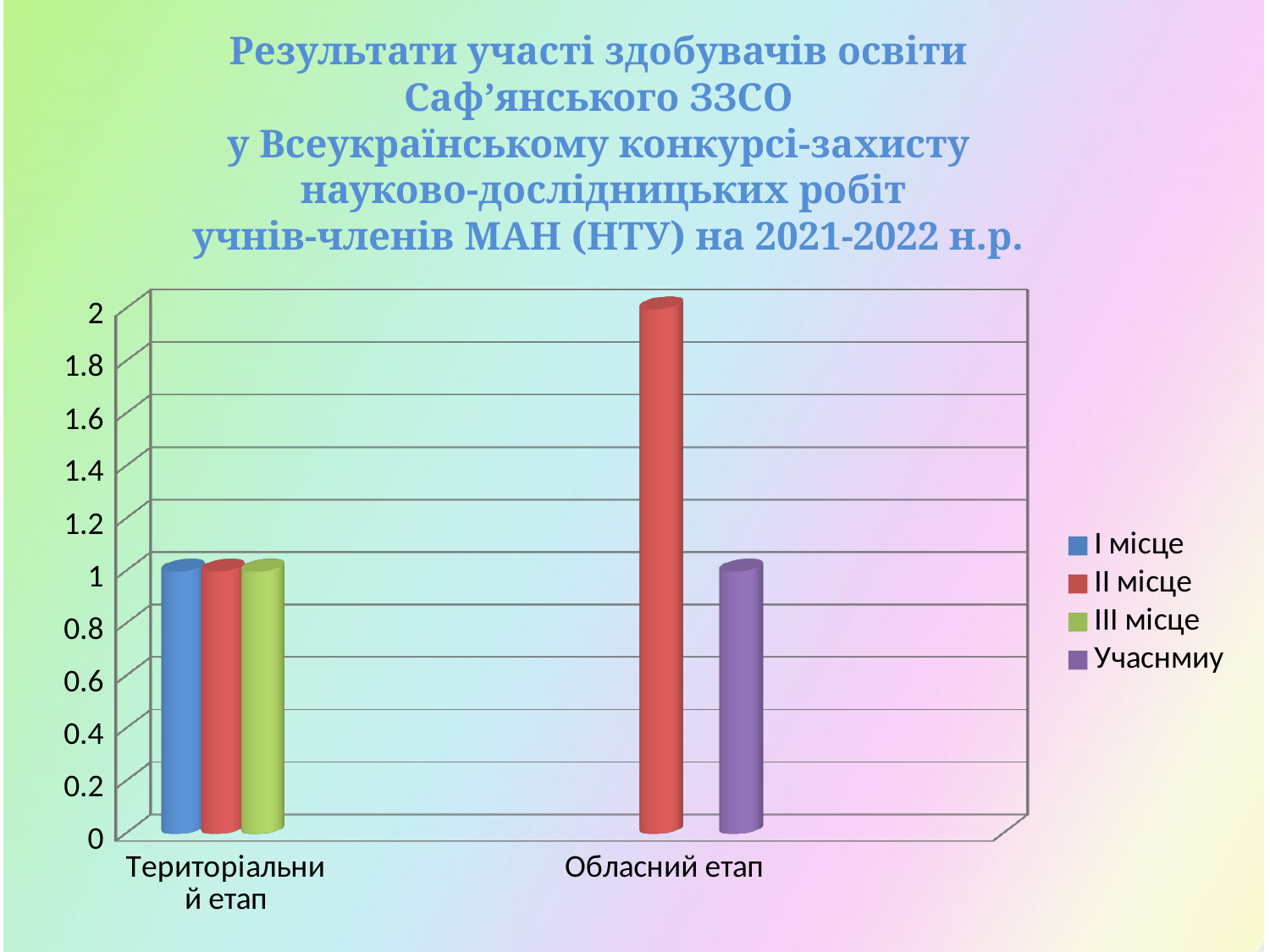
Which legend entry is shown in purple? Учаснмиу Is the value for III місце at Територіальний етап greater or less than 1.5? less Which series has the highest value at Обласний етап? II місце What is the value for Учаснмиу at Обласний етап? 1 Is the value for II місце at Обласний етап greater or less than 1.5? greater How many series does the legend list? 4 What is the value for II місце at Обласний етап? 2 What is the difference between II місце at Обласний етап and Учаснмиу at Обласний етап? 1 How many categories are shown on the x axis? 2 What is the value for I місце at Територіальний етап? 1 What kind of chart is shown on the slide? bar chart Which is larger: II місце at Обласний етап or II місце at Територіальний етап? II місце at Обласний етап